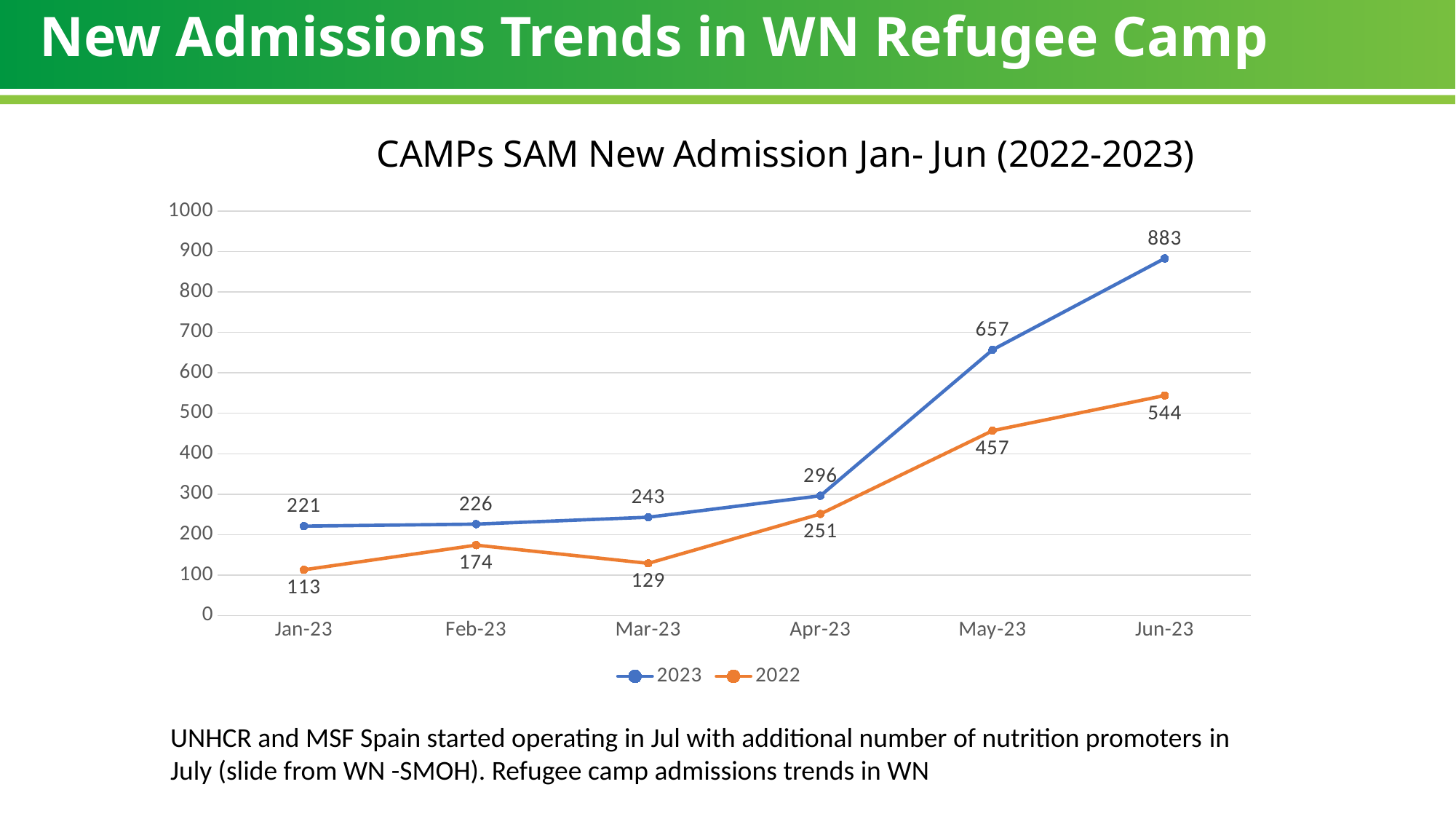
What is the title of the chart? CAMPs SAM New Admission Jan- Jun (2022-2023) What is the difference between the 2023 and 2022 values in May-23? 200 How many months are shown on the x axis? 6 What is the value for the 2022 series in Mar-23? 129 Does the 2023 series rise or fall from Jan-23 to Jun-23? Rise What kind of chart is shown on the slide? Line chart Which series has the larger value in Feb-23, 2023 or 2022? 2023 How many series does the legend list? 2 What is the value for the 2023 series in Apr-23? 296 In which month is the 2022 series at its lowest value? Jan-23 What is the value for the 2023 series in Jun-23? 883 In which month does the 2022 series reach its highest value? Jun-23